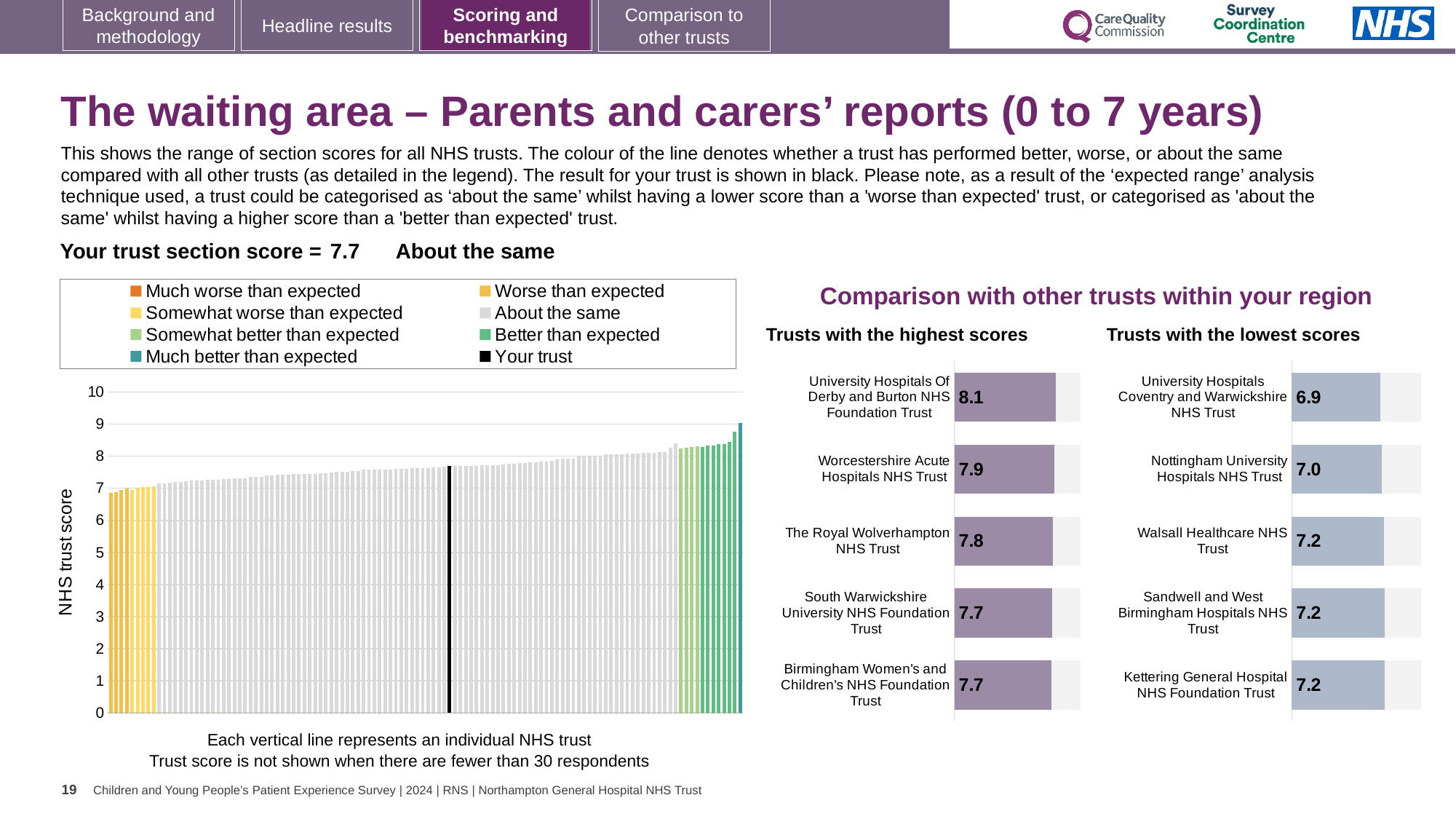
How many entries does the legend of the large chart on the left list? 8 In the large chart on the left, do the trust scores rise or fall from left to right? Rise In the 'Trusts with the highest scores' chart, which trust has the highest score? University Hospitals Of Derby and Burton NHS Foundation Trust In the 'Trusts with the lowest scores' chart, which trust has the lowest score? University Hospitals Coventry and Warwickshire NHS Trust In the 'Trusts with the highest scores' chart, what is the score for The Royal Wolverhampton NHS Trust? 7.8 In the 'Trusts with the highest scores' chart, what is the difference between the scores of University Hospitals Of Derby and Burton NHS Foundation Trust and Worcestershire Acute Hospitals NHS Trust? 0.2 How many trusts are shown in the 'Trusts with the lowest scores' chart? 5 In the 'Trusts with the lowest scores' chart, what is the score for Nottingham University Hospitals NHS Trust? 7.0 In the 'Trusts with the highest scores' chart, what is the score for University Hospitals Of Derby and Burton NHS Foundation Trust? 8.1 What is the difference between the score for University Hospitals Of Derby and Burton NHS Foundation Trust in the highest-scores chart and the score for University Hospitals Coventry and Warwickshire NHS Trust in the lowest-scores chart? 1.2 What kind of chart is the large chart on the left showing all NHS trusts? Bar chart In the 'Trusts with the lowest scores' chart, which has the larger score: Walsall Healthcare NHS Trust or University Hospitals Coventry and Warwickshire NHS Trust? Walsall Healthcare NHS Trust